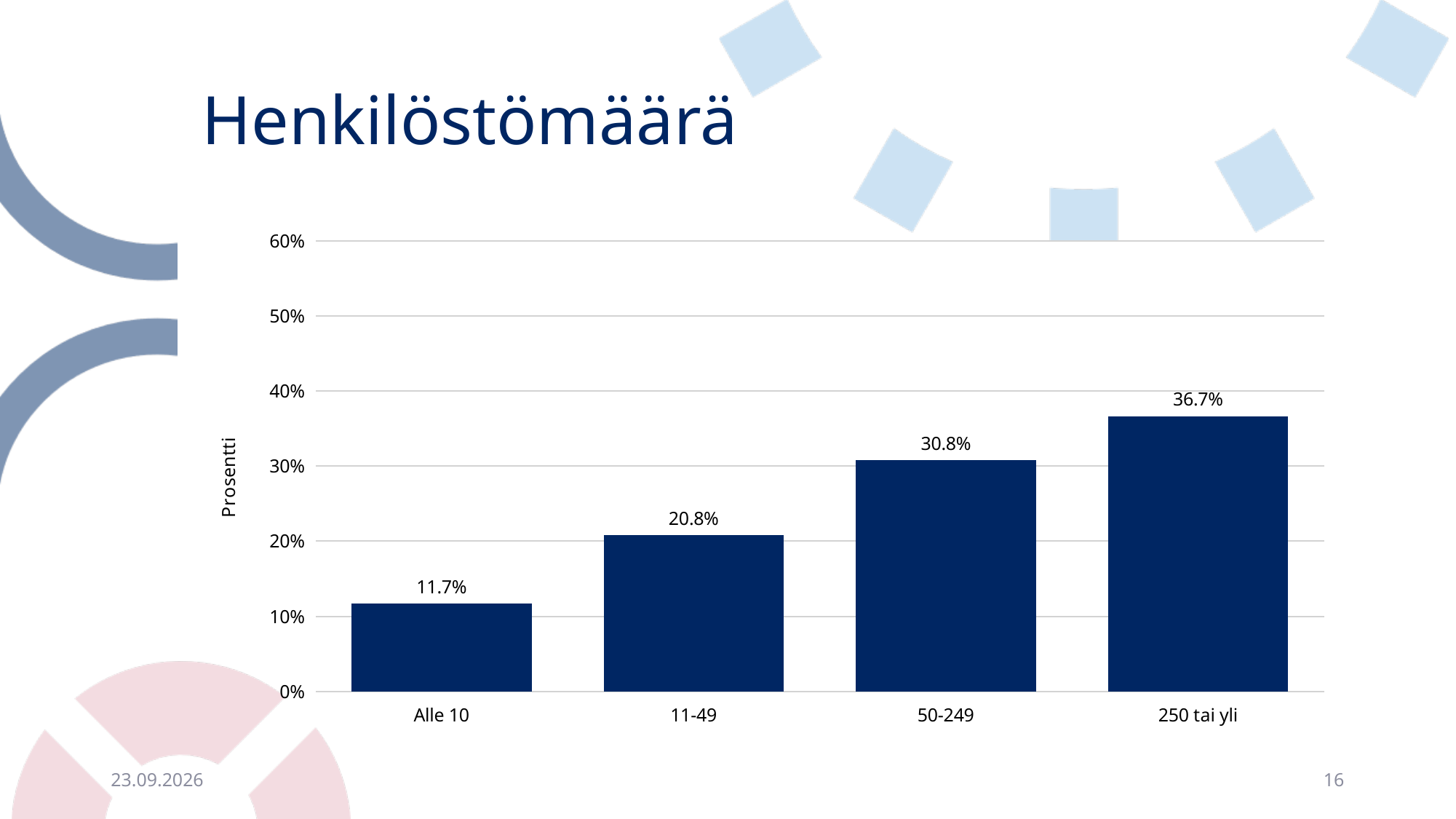
What is the difference between the values for '250 tai yli' and 'Alle 10'? 25.0% What is the value for the 'Alle 10' category? 11.7% What kind of chart is shown on the slide? Bar chart Which category has the lowest value? Alle 10 How many categories are shown on the x axis? 4 What is the difference between the values for '50-249' and '11-49'? 10.0% What is the value for the '250 tai yli' category? 36.7% Which category has the highest value? 250 tai yli What is the value for the '11-49' category? 20.8% Which is larger, the value for '11-49' or the value for '50-249'? 50-249 What is the value for the '50-249' category? 30.8% Do the values rise or fall from left to right along the x axis? Rise